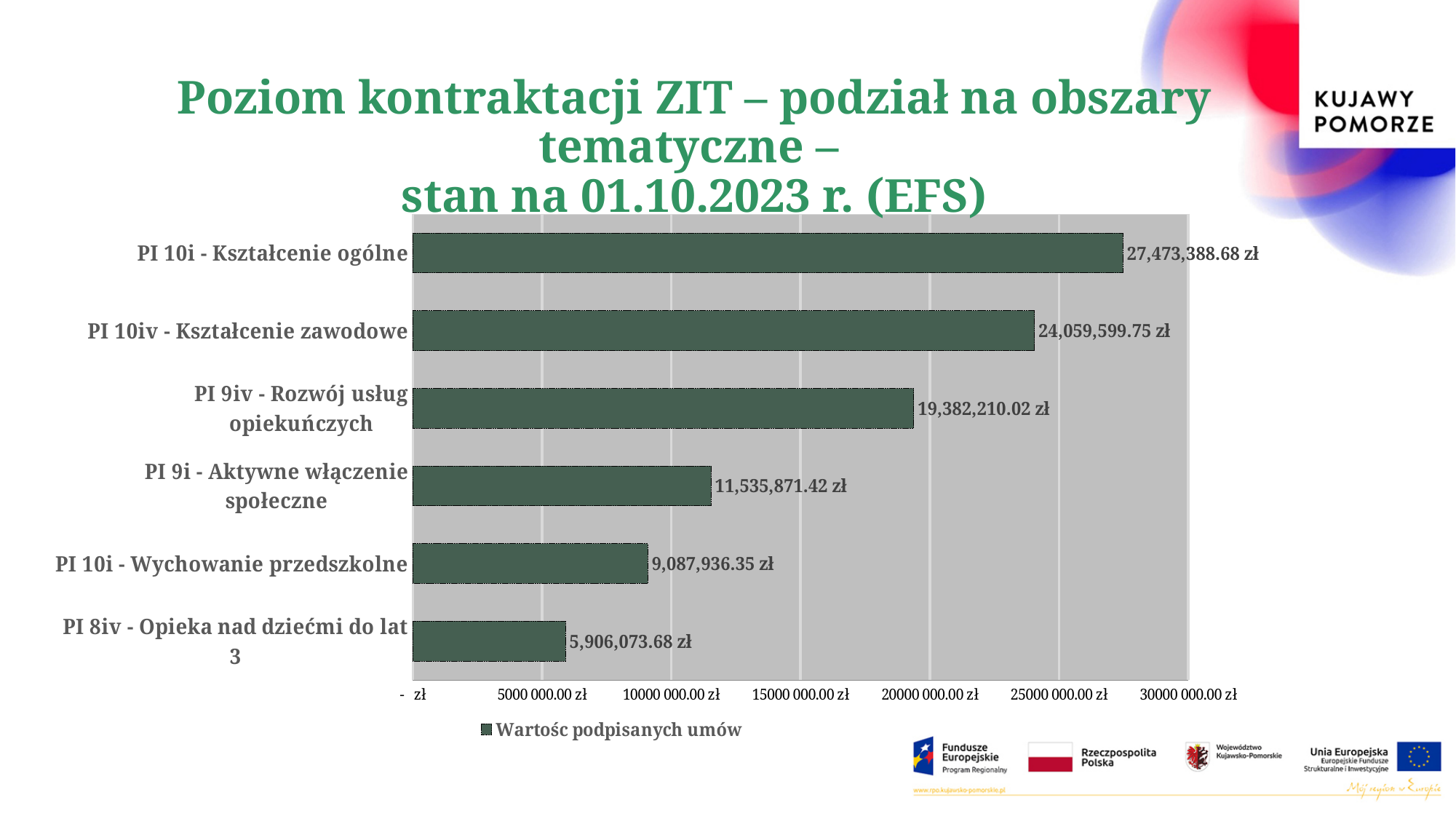
What series name does the legend show? Wartośc podpisanych umów Which category has the highest value? PI 10i - Kształcenie ogólne What is the difference between the values for PI 10i - Wychowanie przedszkolne and PI 8iv - Opieka nad dziećmi do lat 3? 3,181,862.67 zł What is the value for PI 10i - Wychowanie przedszkolne? 9,087,936.35 zł What kind of chart is shown on the slide? Bar chart What is the difference between the values for PI 10i - Kształcenie ogólne and PI 10iv - Kształcenie zawodowe? 3,413,788.93 zł What is the value for PI 10i - Kształcenie ogólne? 27,473,388.68 zł How many categories are shown in the chart? 6 Which category has the lowest value? PI 8iv - Opieka nad dziećmi do lat 3 Which is larger: the value for PI 9i - Aktywne włączenie społeczne or the value for PI 10i - Wychowanie przedszkolne? PI 9i - Aktywne włączenie społeczne What is the value for PI 9iv - Rozwój usług opiekuńczych? 19,382,210.02 zł What is the value for PI 8iv - Opieka nad dziećmi do lat 3? 5,906,073.68 zł